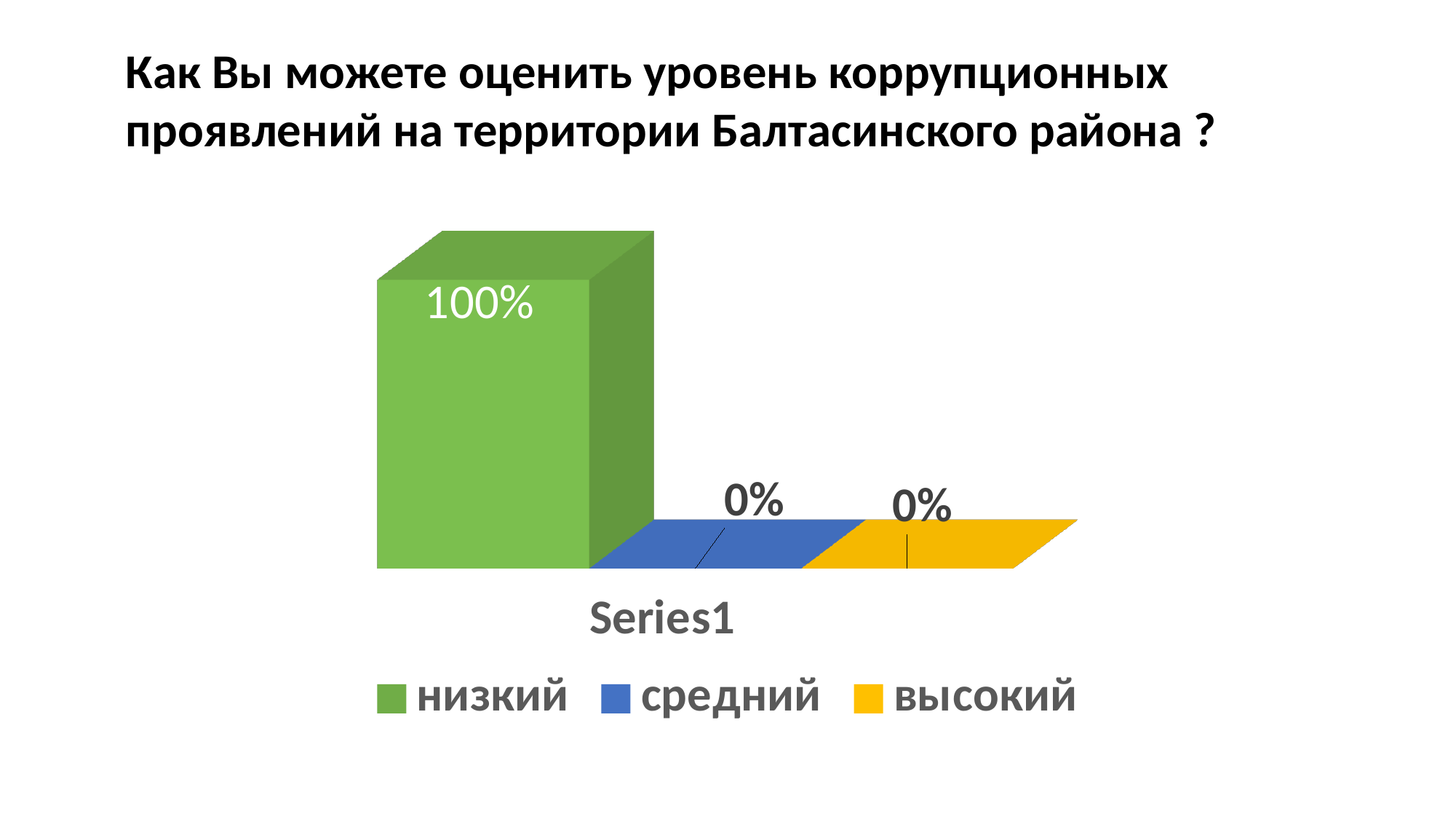
What is the value for высокий? 0% What colour is the bar for низкий? green How many series does the legend list? 3 What kind of chart is shown on the slide? bar chart What is the difference between the values for низкий and средний? 100% What is the value for средний? 0% Which is larger, the value for низкий or the value for высокий? низкий What is the value for низкий? 100% Which series has the highest value? низкий What is the category label shown on the x axis? Series1 What is the total of the three values shown? 100%